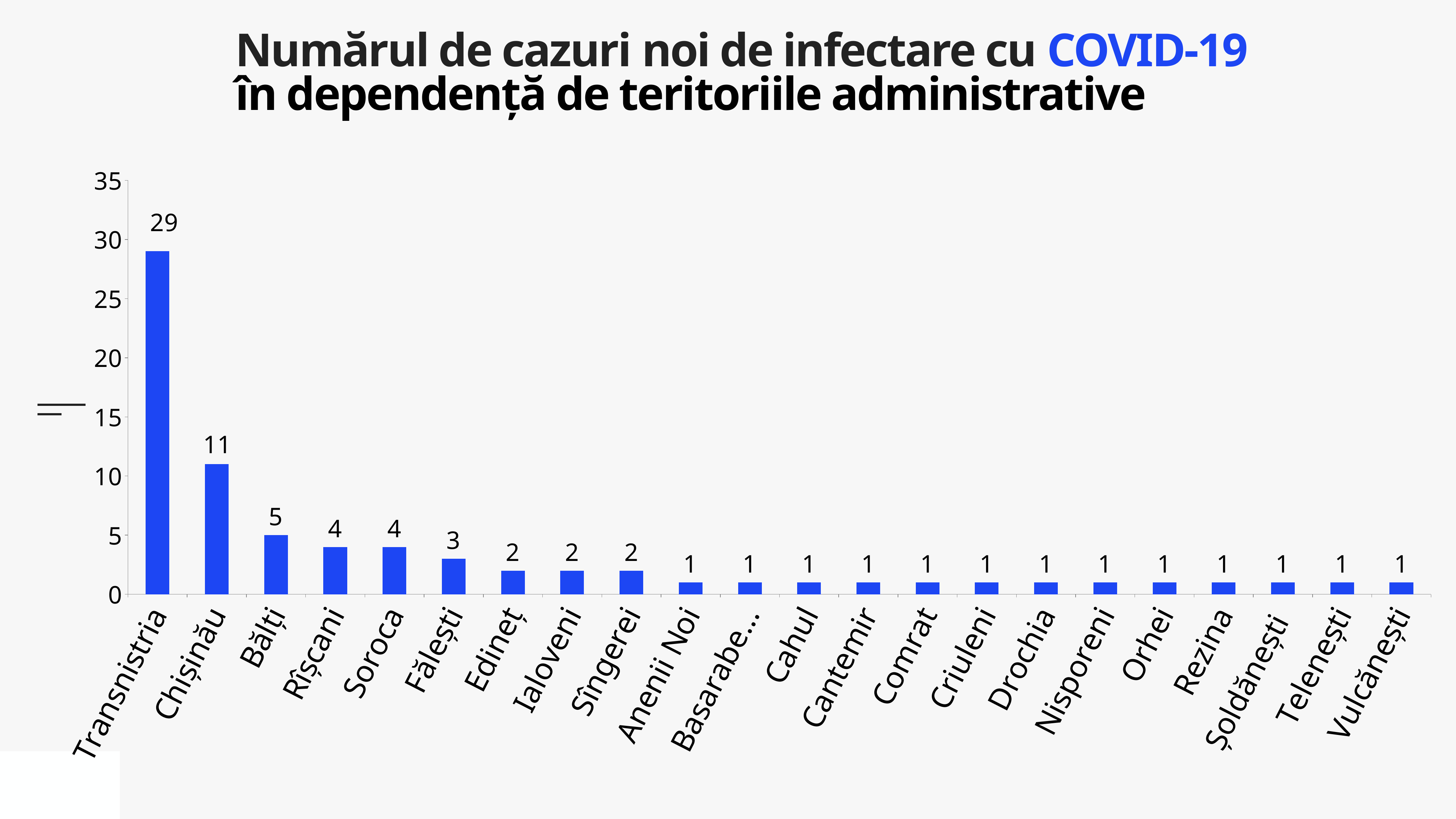
How many categories are shown on the x axis? 22 What is the difference between the values for Transnistria and Chișinău? 18 Is the value for Transnistria greater or less than 25? greater What is the value for Orhei? 1 What is the value for Transnistria? 29 What is the value for Edineț? 2 What is the value for Chișinău? 11 Which category has the highest value? Transnistria What type of chart is shown on the slide? bar chart What is the value for Fălești? 3 What is the value for Bălți? 5 Which has a larger value, Bălți or Soroca? Bălți